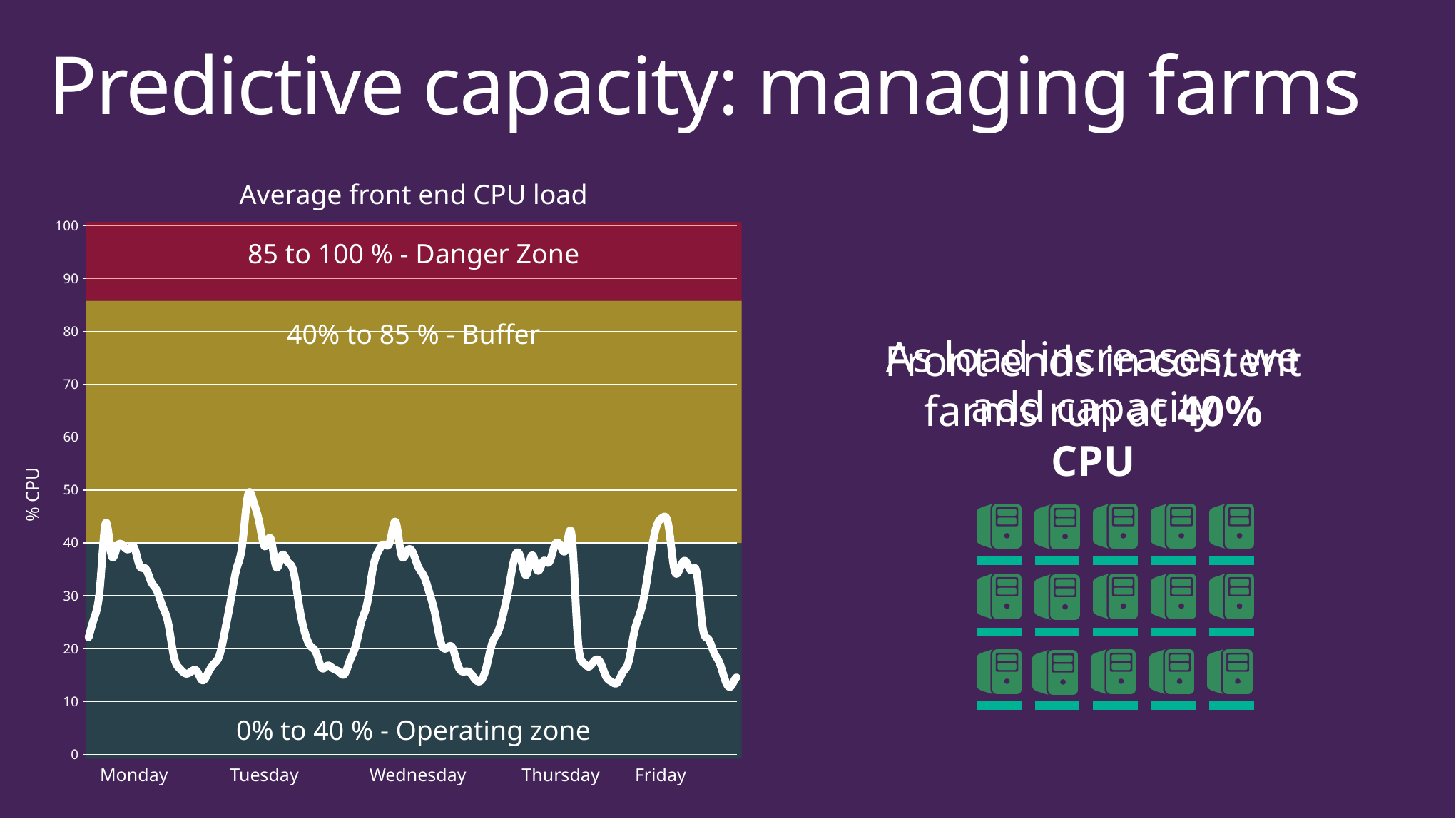
Is the peak CPU load on Tuesday greater or less than 40? greater Is the lowest CPU load on Wednesday greater or less than 20? less What is the title of the chart? Average front end CPU load What is the highest value shown on the y axis of the chart? 100 Is the peak CPU load on Tuesday greater or less than 60? less What is the label on the y axis of the chart? % CPU What kind of chart is shown on the slide? line chart Which day has the highest peak CPU load on the chart? Tuesday Is the peak CPU load on Tuesday higher or lower than the peak on Thursday? higher How many days are labelled along the x axis of the chart? 5